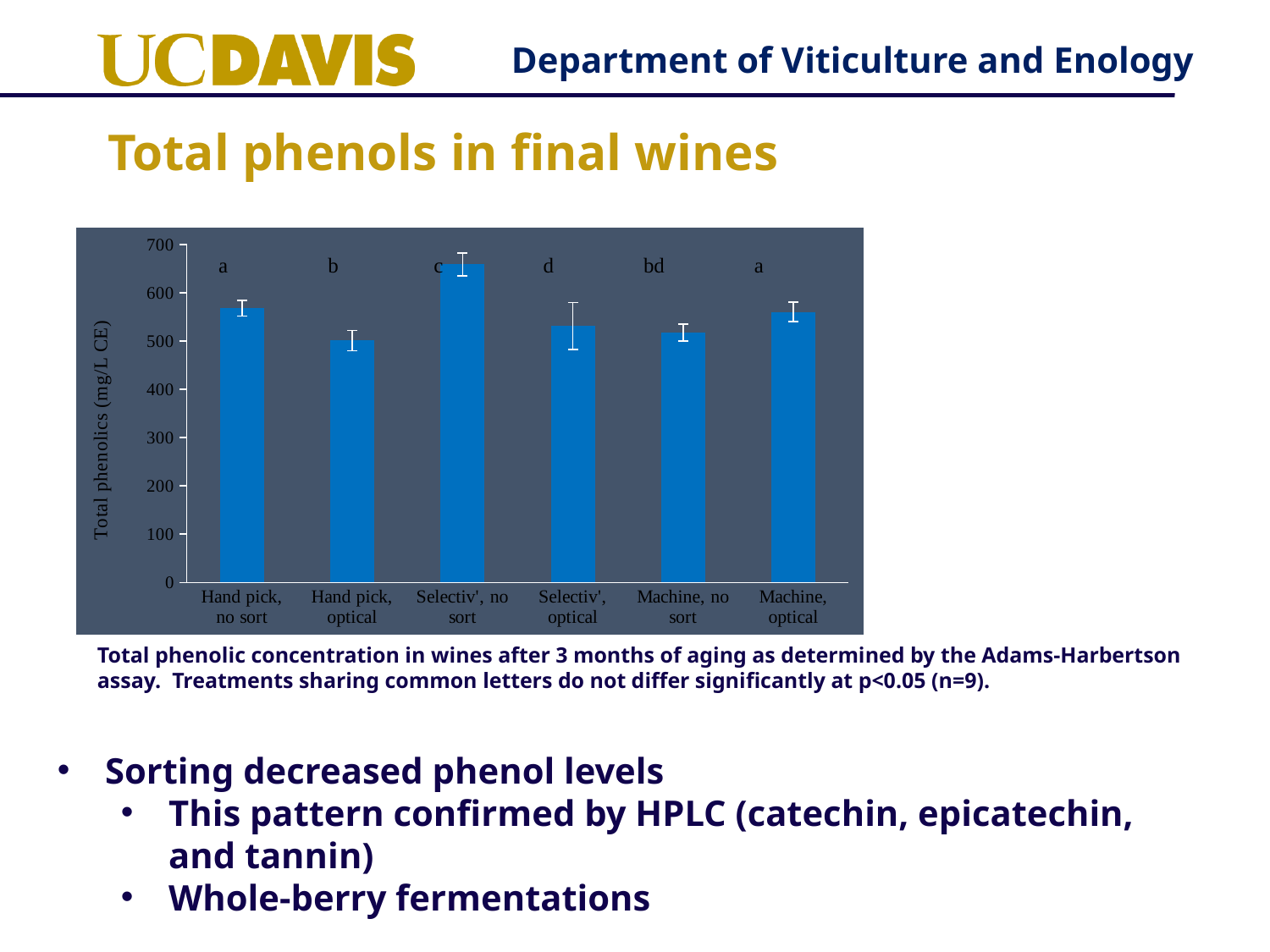
Which treatment has the highest total phenolics in the chart? Selectiv', no sort Which has a higher total phenolics value, Selectiv', no sort or Selectiv', optical? Selectiv', no sort Is the value for Hand pick, no sort greater or less than 500? greater Is the value for Selectiv', no sort greater or less than 600? greater What significance letter is printed above the Selectiv', no sort bar? c Is the value for Machine, no sort greater or less than 600? less What is the label on the y axis of the chart? Total phenolics (mg/L CE) Which has a higher total phenolics value, Hand pick, no sort or Hand pick, optical? Hand pick, no sort What kind of chart is shown on the slide? bar chart How many treatment categories are shown on the x axis of the chart? 6